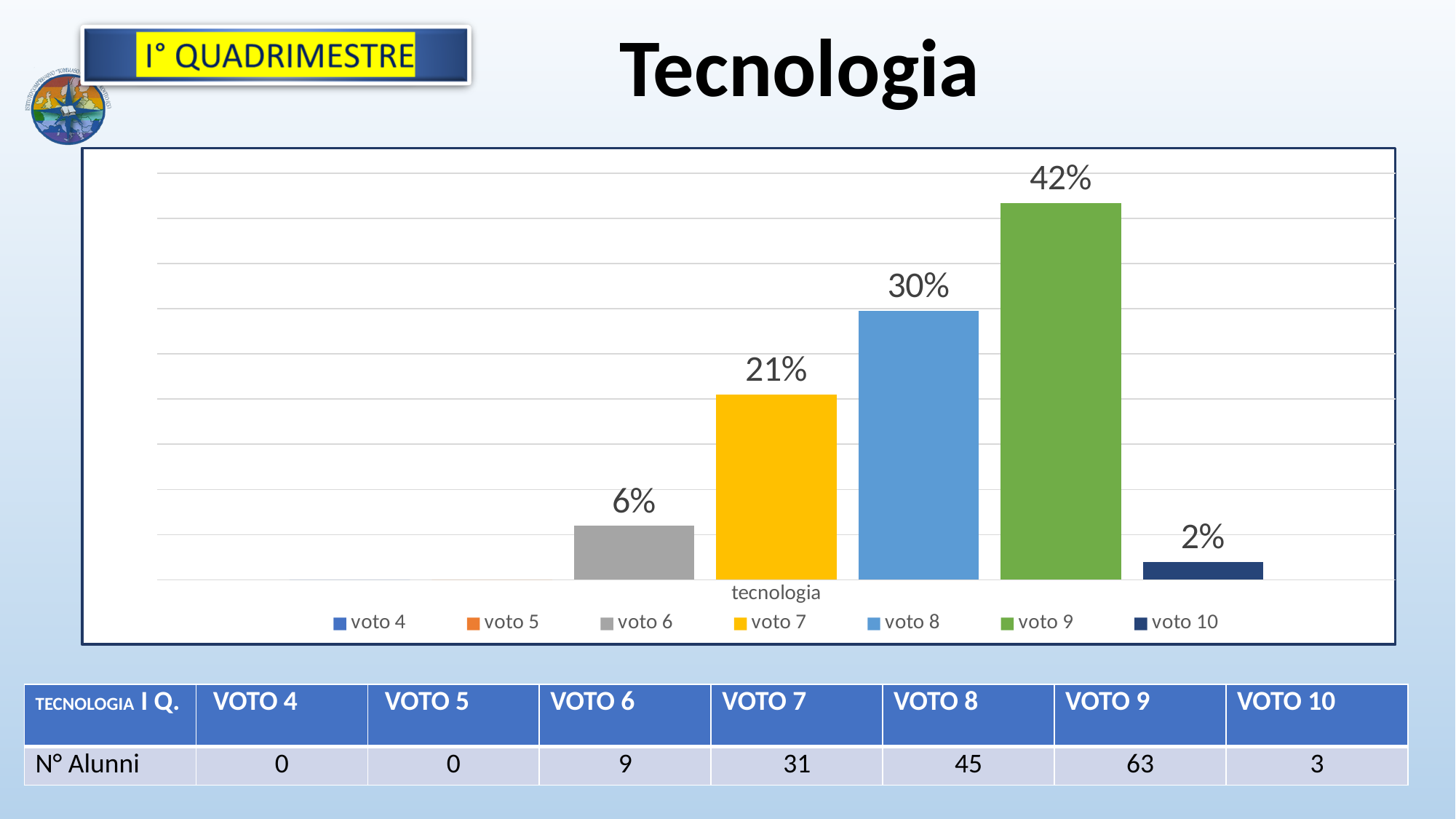
Which series has the highest value in the chart? voto 9 What kind of chart is shown on the slide? bar chart What percentage is shown for voto 10 in the chart? 2% Among the series with visible bars, which has the lowest value? voto 10 What percentage is shown for voto 7 in the chart? 21% What is the difference between the values for voto 8 and voto 7? 9% What is the category label shown on the x axis of the chart? tecnologia How many series does the legend list? 7 Which is larger, the value for voto 7 or the value for voto 6? voto 7 What is the difference between the values for voto 9 and voto 8? 12% What colour is the bar for voto 9? green What percentage is shown for voto 9 in the chart? 42%